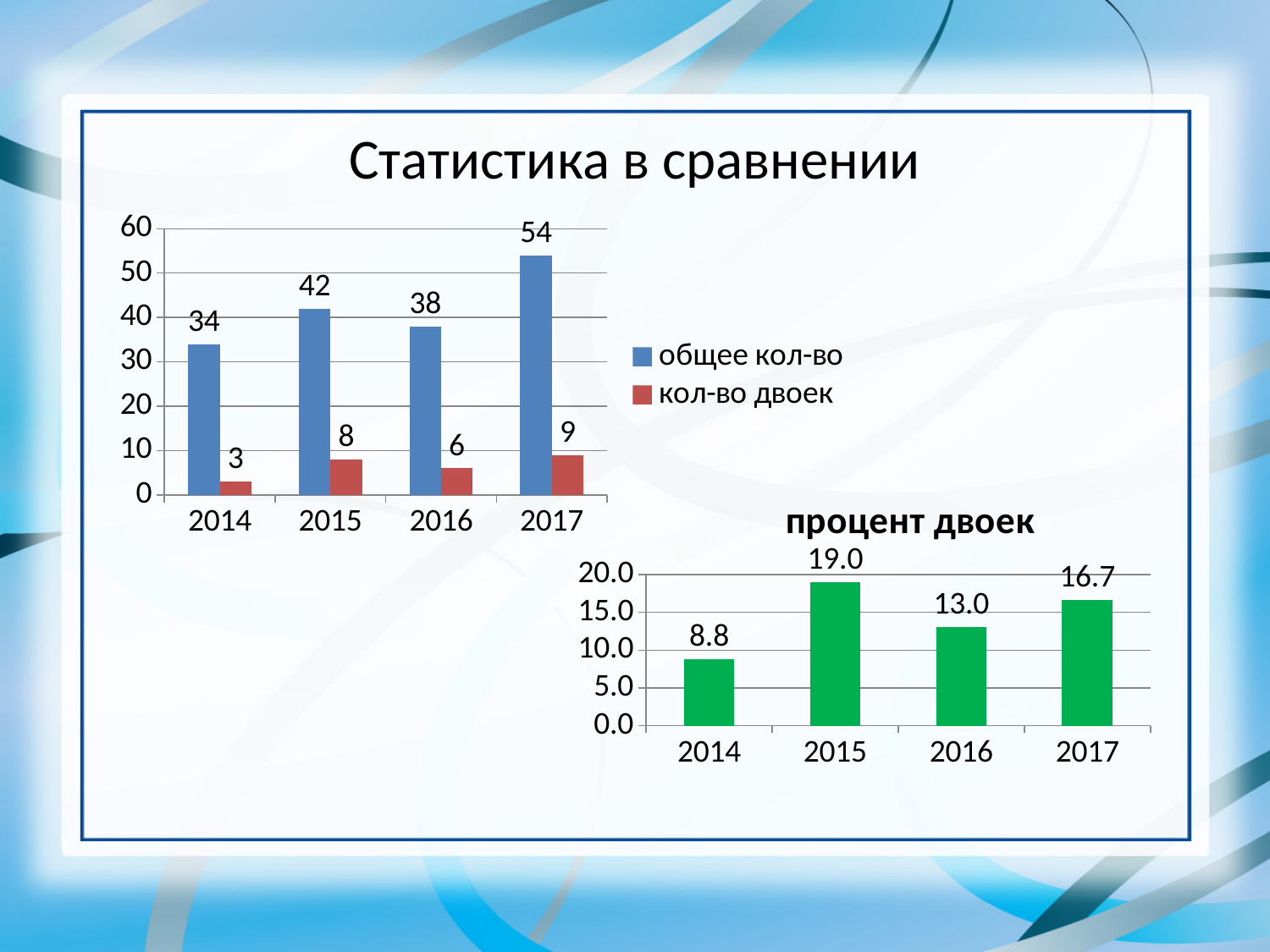
In the top-left chart, which is larger: общее кол-во in 2015 or in 2016? 2015 In the top-left chart, what is the difference between общее кол-во in 2017 and 2016? 16 In the top-left chart, what is the value of кол-во двоек for 2015? 8 How many series does the legend of the top-left chart list? 2 In the top-left chart, which year has the highest общее кол-во? 2017 In the top-left chart, what is the value of общее кол-во for 2017? 54 In the chart titled 'процент двоек', what is the difference between the values for 2017 and 2016? 3.7 In the chart titled 'процент двоек', what is the value for 2015? 19.0 In the chart titled 'процент двоек', which year has the lowest value? 2014 What type of chart is the chart titled 'процент двоек'? bar chart How many years are shown on the x axis of the chart titled 'процент двоек'? 4 In the top-left chart, which year has the lowest кол-во двоек? 2014